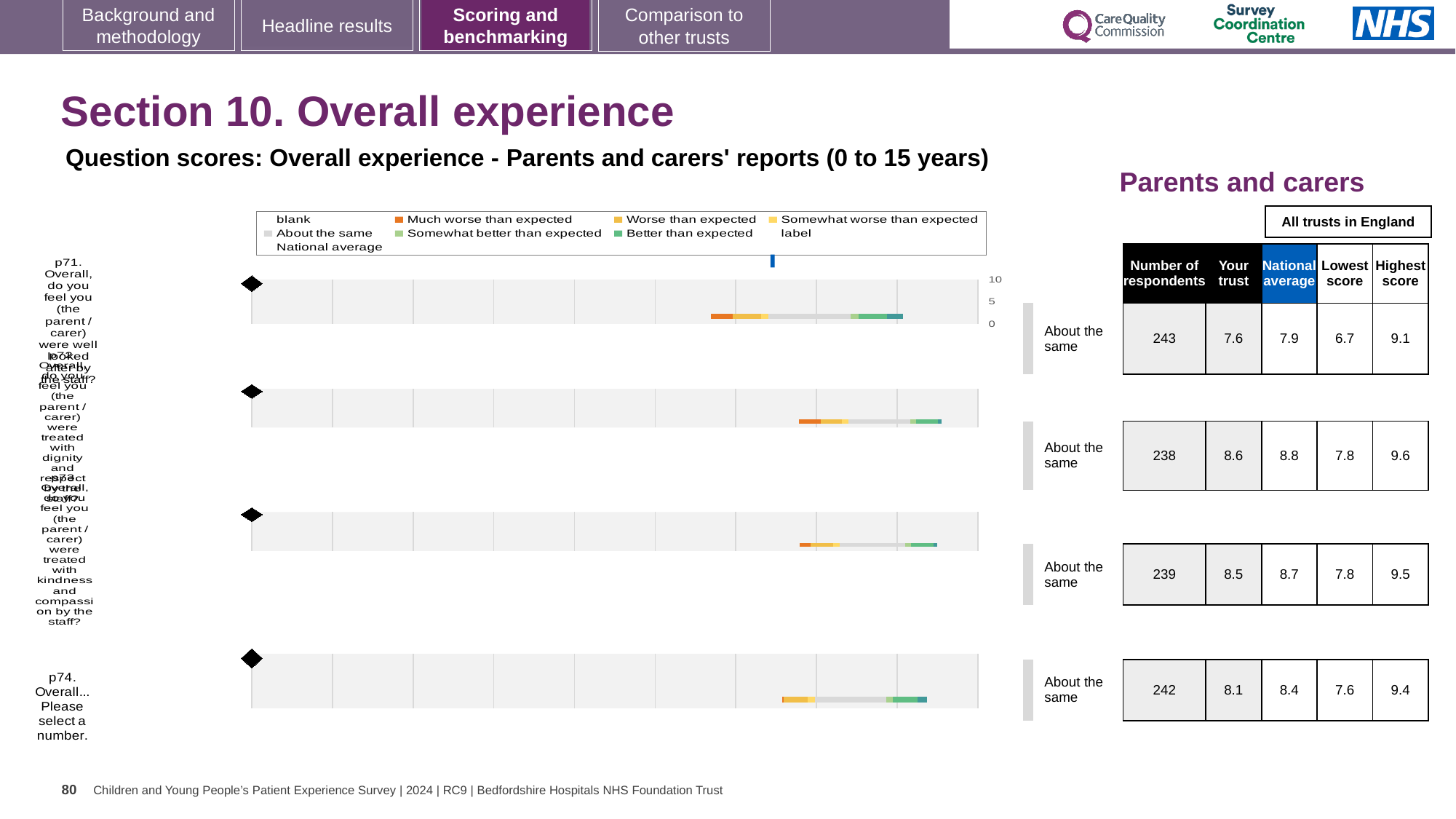
What kind of chart is used to show the question scores on this slide? bar chart In the table next to the chart, is the 'Your trust' score for the second row (8.6) larger or smaller than the national average for that row (8.8)? smaller In the table next to the chart, what is the 'Your trust' score for the first row (p71, overall well looked after by the staff)? 7.6 In the table next to the chart, which row has the lowest 'Your trust' score? the first row, p71 (7.6) What benchmark category is shown beside each of the four bars in the chart? About the same How many questions (bars) are plotted in the chart? 4 In the table next to the chart, how many respondents are listed for the last row (p74, Overall... Please select a number)? 242 In the table next to the chart, which row has the highest 'Your trust' score? the second row (8.6) In the table next to the chart, what is the difference between the national average and the 'Your trust' score for the last row (p74)? 0.3 What is the title of the table to the right of the chart? Parents and carers In the table next to the chart, what is the highest score for the last row (p74)? 9.4 In the table next to the chart, what is the national average for the first row (p71)? 7.9